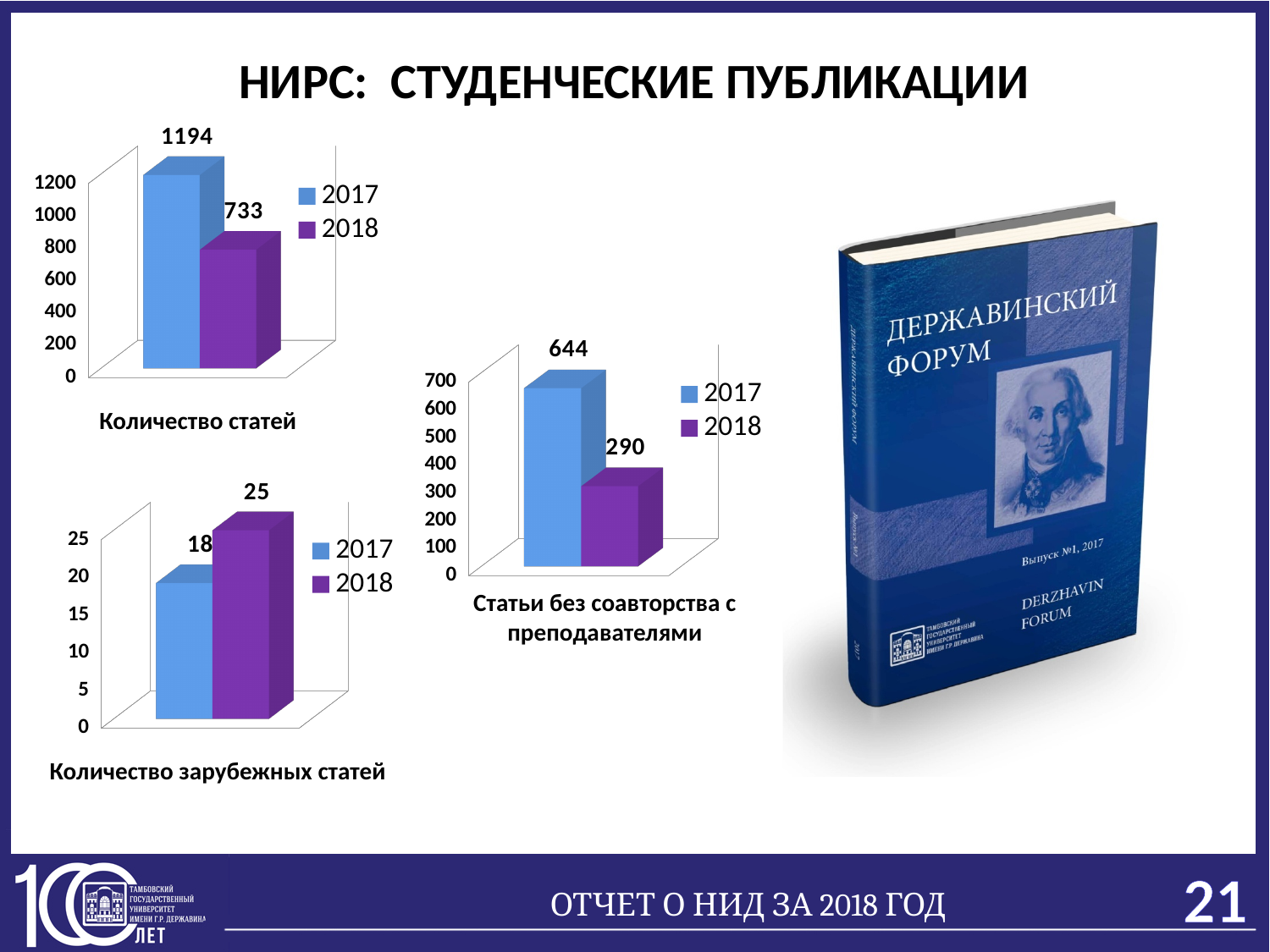
In the chart titled 'Статьи без соавторства с преподавателями', what is the value for 2017? 644 In the chart titled 'Статьи без соавторства с преподавателями', what is the value for 2018? 290 In the chart titled 'Количество зарубежных статей', what is the value for 2017? 18 In the chart titled 'Количество зарубежных статей', what is the value for 2018? 25 In the chart titled 'Статьи без соавторства с преподавателями', which year has the higher value? 2017 What kind of chart is the chart titled 'Статьи без соавторства с преподавателями'? Bar chart In the chart titled 'Количество статей', what is the value for 2017? 1194 In the chart titled 'Количество статей', what is the difference between the 2017 and 2018 values? 461 How many series does the legend of the chart titled 'Количество статей' list? 2 In the chart titled 'Количество статей', what is the value for 2018? 733 In the chart titled 'Количество зарубежных статей', what is the difference between the 2018 and 2017 values? 7 In the chart titled 'Количество зарубежных статей', which year has the lower value? 2017